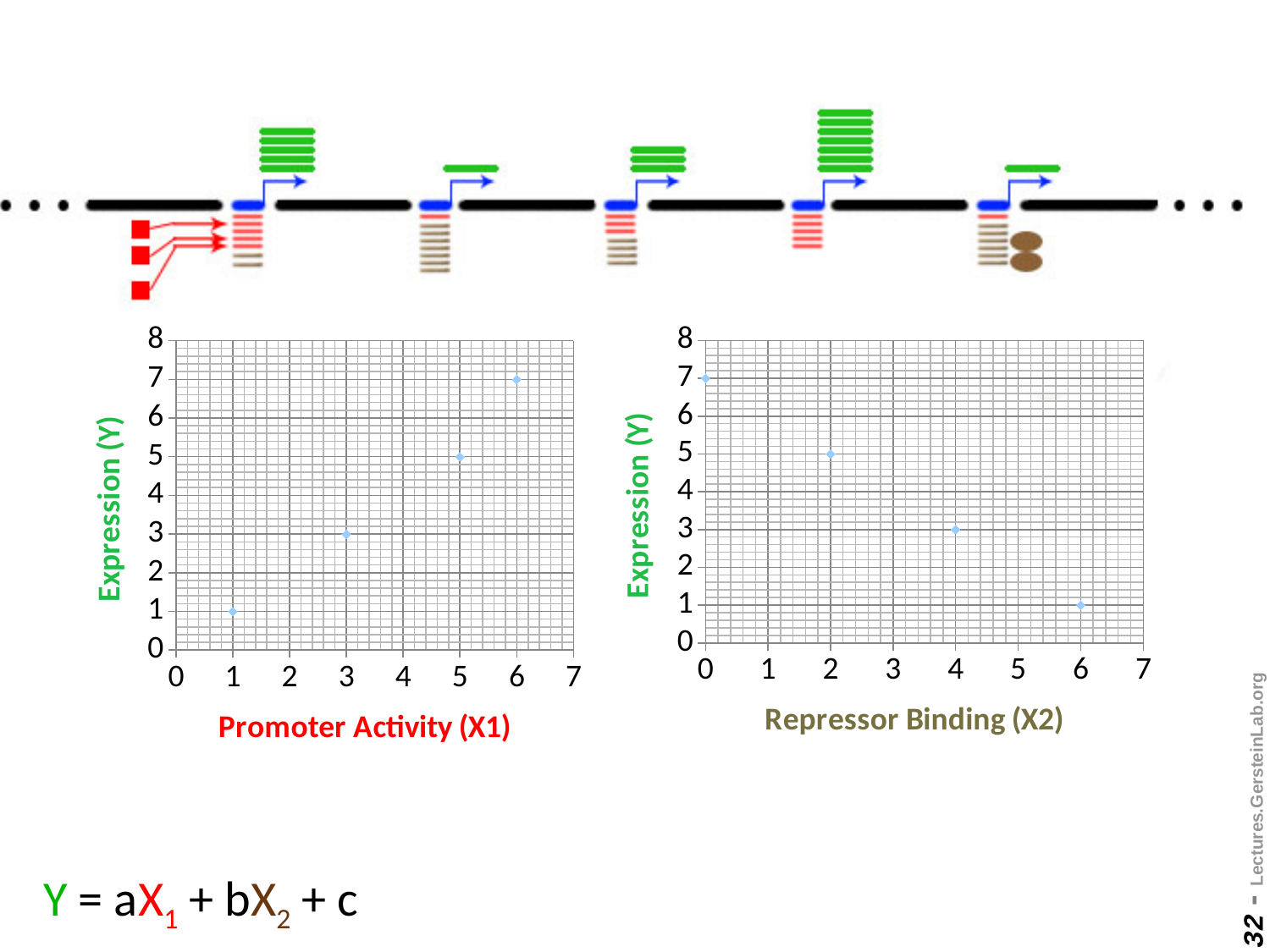
In the left chart (Promoter Activity (X1)), what is the Expression (Y) value at Promoter Activity 6? 7 In the left chart (Promoter Activity (X1)), does Expression (Y) rise or fall as Promoter Activity increases? rise In the right chart (Repressor Binding (X2)), what is the Expression (Y) value at Repressor Binding 4? 3 In the left chart (Promoter Activity (X1)), what is the difference in Expression (Y) between Promoter Activity 6 and Promoter Activity 1? 6 What kind of chart is the left chart (Promoter Activity (X1))? scatter chart In the left chart (Promoter Activity (X1)), what is the Expression (Y) value at Promoter Activity 3? 3 In the right chart (Repressor Binding (X2)), what is the Expression (Y) value at Repressor Binding 0? 7 In the right chart (Repressor Binding (X2)), how many data points are plotted? 4 In the right chart (Repressor Binding (X2)), at which Repressor Binding value is Expression (Y) lowest? 6 What is the x-axis title of the right chart? Repressor Binding (X2) In the left chart (Promoter Activity (X1)), how many data points are plotted? 4 In the right chart (Repressor Binding (X2)), does Expression (Y) rise or fall as Repressor Binding increases? fall